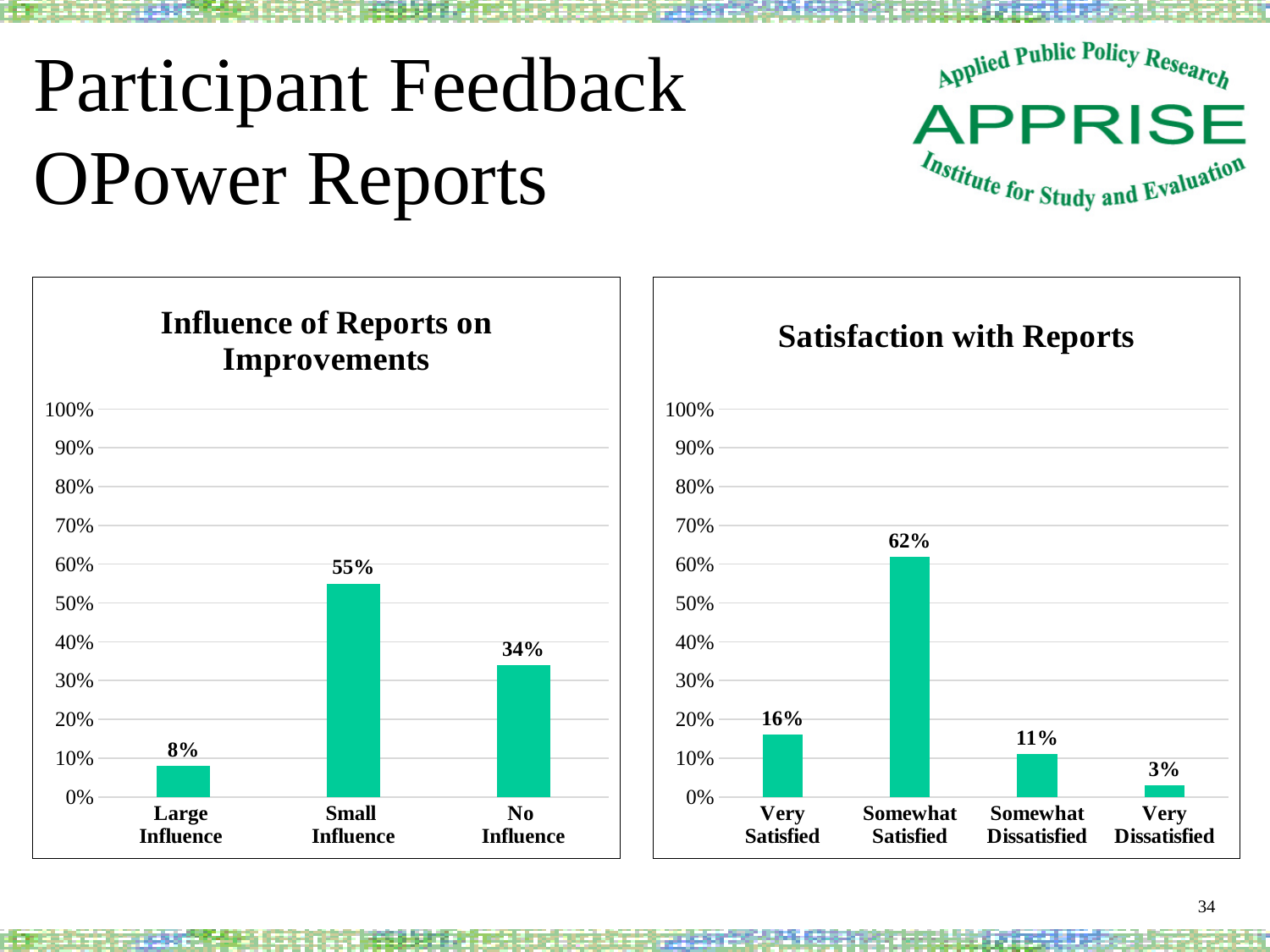
In the 'Influence of Reports on Improvements' chart, is the value for No Influence greater or less than 40%? less In the 'Satisfaction with Reports' chart, how many categories are shown? 4 In the 'Satisfaction with Reports' chart, which is larger, Somewhat Dissatisfied or Very Dissatisfied? Somewhat Dissatisfied In the 'Influence of Reports on Improvements' chart, which category has the lowest value? Large Influence What is the title of the chart on the left side of the slide? Influence of Reports on Improvements What kind of chart is the 'Satisfaction with Reports' chart? Bar chart In the 'Satisfaction with Reports' chart, which category has the highest value? Somewhat Satisfied In the 'Satisfaction with Reports' chart, what is the difference between Somewhat Satisfied and Very Satisfied? 46% In the 'Influence of Reports on Improvements' chart, what is the value for Small Influence? 55% In the 'Influence of Reports on Improvements' chart, what is the difference between Small Influence and No Influence? 21% In the 'Satisfaction with Reports' chart, what is the value for Very Satisfied? 16% In the 'Influence of Reports on Improvements' chart, how many categories are shown? 3